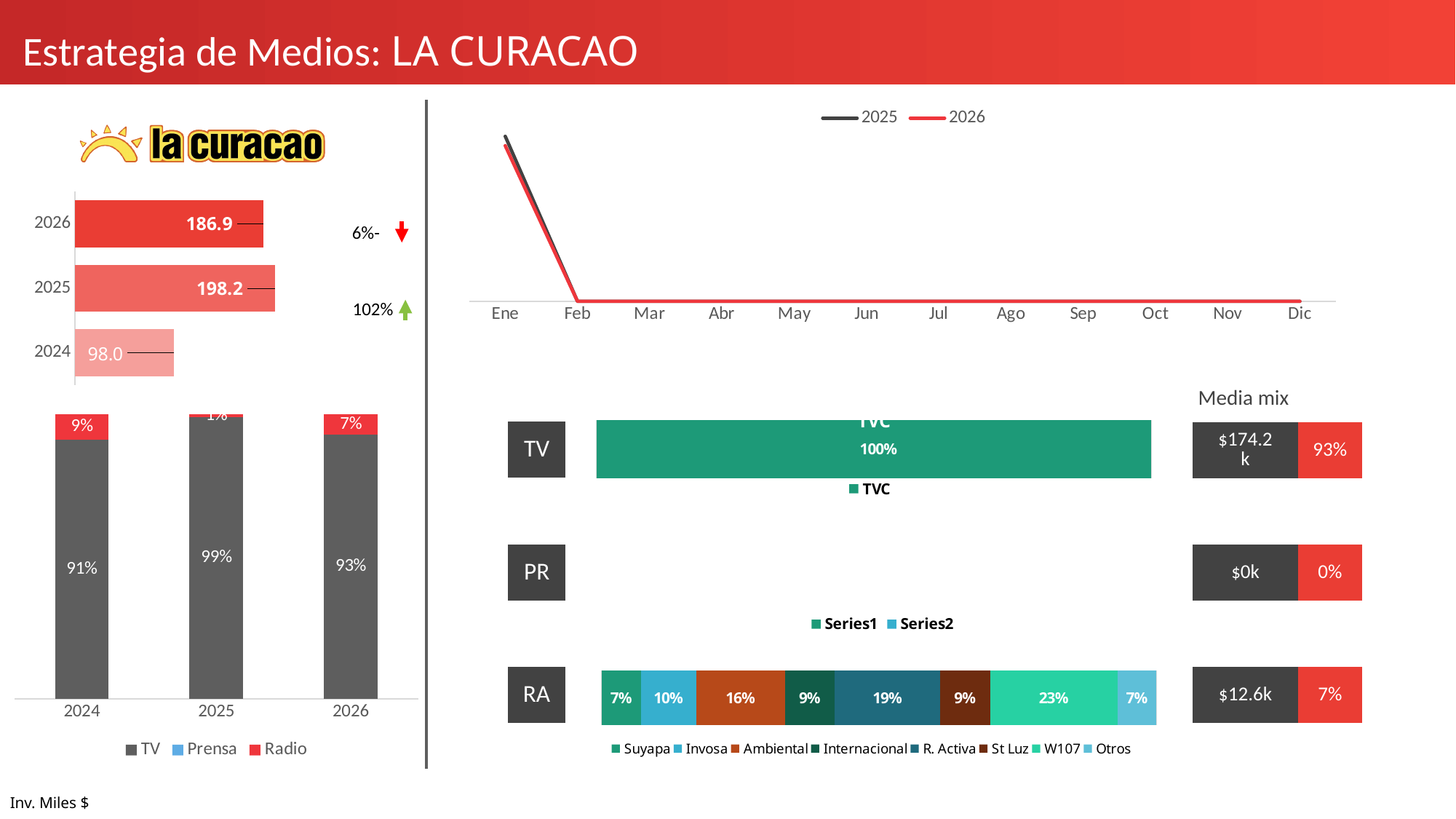
In the RA stacked bar chart, what is the share for R. Activa? 19% In the RA stacked bar chart, which station has the largest share? W107 In the Media mix table, what is the investment value for RA? $12.6k In the stacked bar chart at the bottom left, what is the TV share for 2025? 99% In the horizontal bar chart on the left, what is the value for 2024? 98.0 In the stacked bar chart at the bottom left, what is the Radio share for 2024? 9% In the line chart at the top right, which two series does the legend list? 2025 and 2026 In the horizontal bar chart on the left, what is the value for 2025? 198.2 In the line chart at the top right, how many months are shown on the x axis? 12 In the horizontal bar chart on the left, what is the difference between the 2025 and 2026 values? 11.3 In the horizontal bar chart on the left, which year has the highest value? 2025 How many series does the legend of the stacked bar chart at the bottom left list? 3